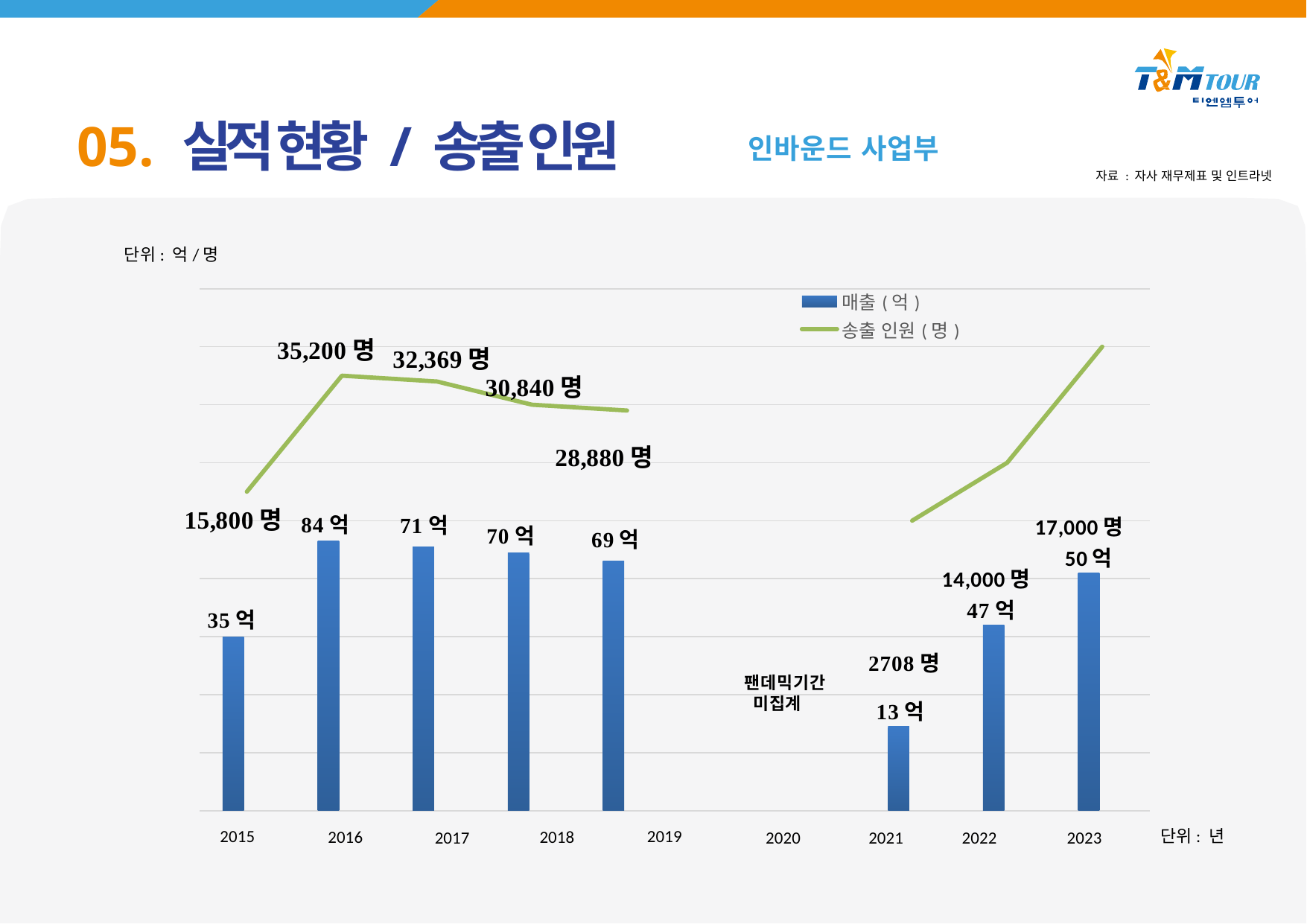
Which year has the lowest 매출 (억)? 2021 What is the 송출 인원 (명) value for 2017? 32,369 명 Which year has the highest 매출 (억)? 2016 What kind of chart is shown on the slide? Combined bar and line chart What does the chart say about the year 2020? 팬데믹기간 미집계 What is the 송출 인원 (명) value for 2023? 17,000 명 What is the difference in 매출 (억) between 2016 and 2015? 49 억 What is the 매출 (억) value for 2021? 13 억 Which is larger, the 매출 (억) for 2022 or for 2023? 2023 What is the difference in 송출 인원 (명) between 2023 and 2022? 3,000 명 What is the 매출 (억) value for 2016? 84 억 How many series does the legend list? 2